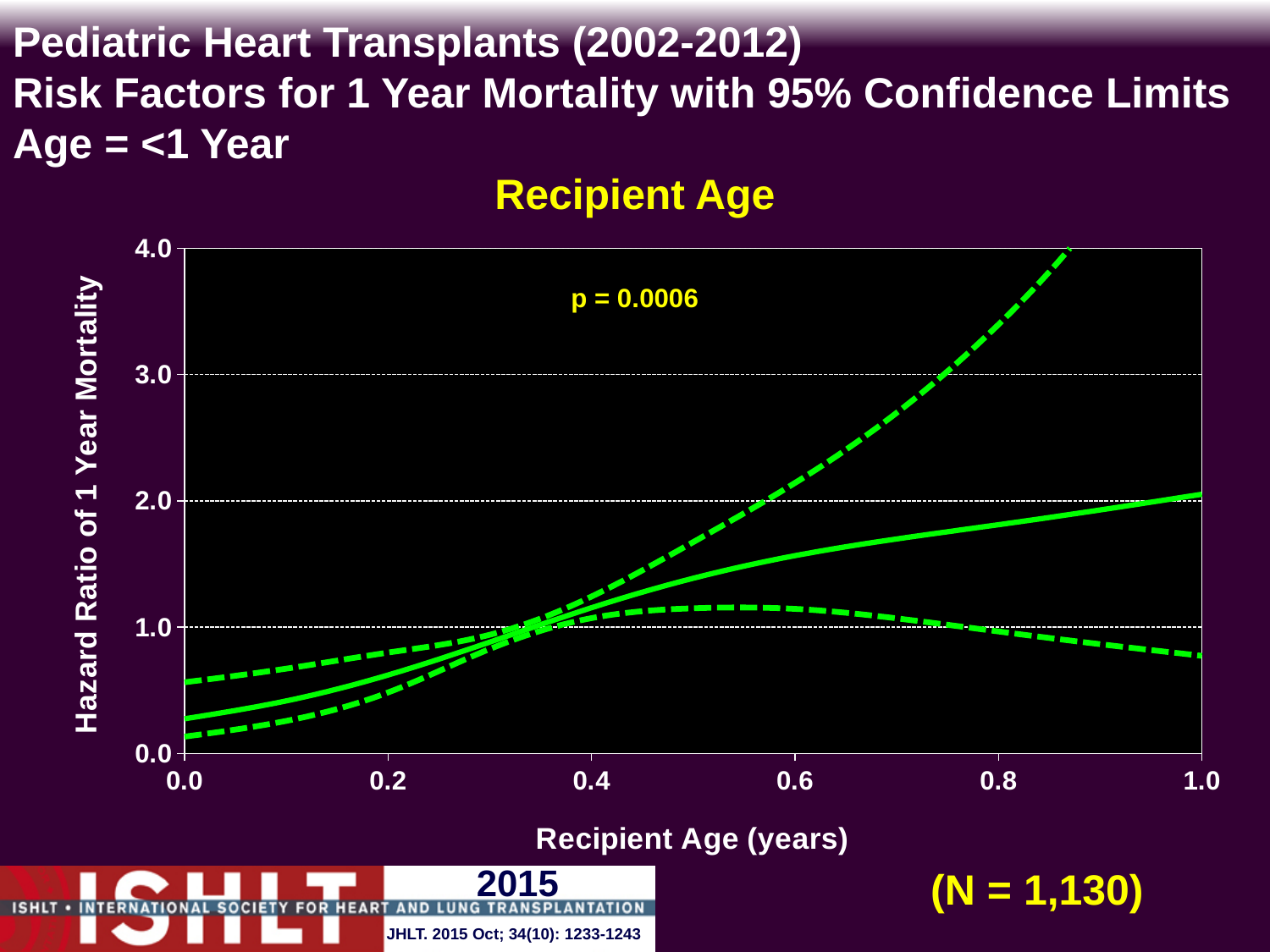
Is the lower confidence limit (lower dashed line) at a recipient age of 0.0 years greater or less than 1.0? less What is the label of the y axis? Hazard Ratio of 1 Year Mortality Is the upper confidence limit (upper dashed line) at a recipient age of 1.0 years greater or less than 3.0? greater What kind of chart is shown on the slide? line chart What is the p-value printed on the chart? p = 0.0006 How many lines are plotted on the chart? 3 Is the hazard ratio (solid line) at a recipient age of 0.0 years greater or less than 1.0? less Which is larger at a recipient age of 1.0 years: the upper dashed confidence limit or the solid hazard ratio line? the upper dashed confidence limit Does the solid hazard ratio line rise or fall as recipient age increases from 0.0 to 1.0 years? rise What is the title of the chart? Recipient Age